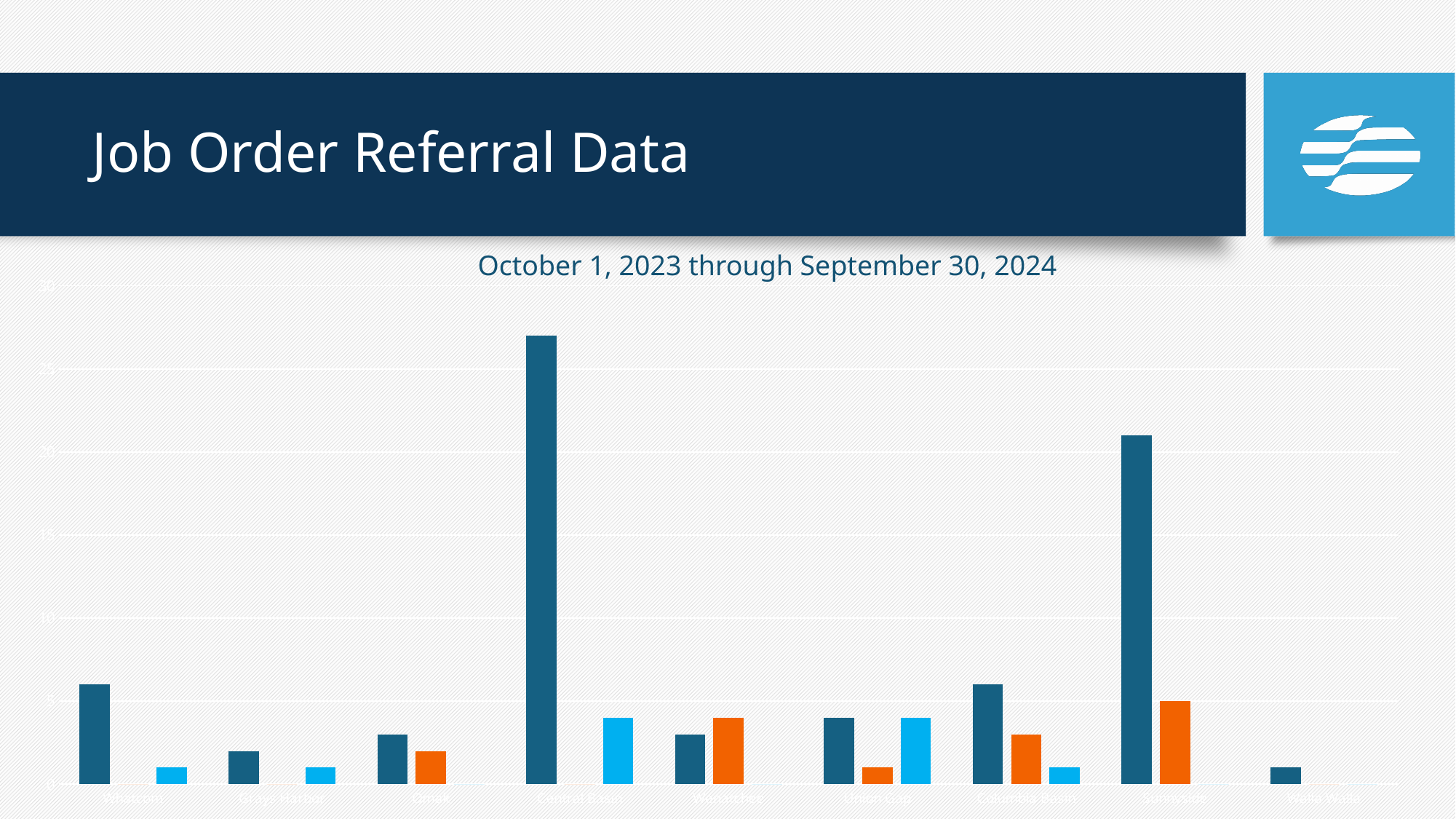
Which category has the tallest bar in the chart? Central Basin Is the orange bar for Sunnyside greater or less than 10? less Which is larger, the dark blue bar for Central Basin or the dark blue bar for Sunnyside? Central Basin Is the dark blue bar for Whatcom greater or less than 5? greater Is the dark blue bar for Sunnyside greater or less than 20? greater How many category groups are shown along the x axis of the chart? 9 What is the title of the slide containing the chart? Job Order Referral Data What date range does the chart's subtitle give? October 1, 2023 through September 30, 2024 Which is larger, the dark blue bar for Columbia Basin or the dark blue bar for Grays Harbor? Columbia Basin What kind of chart is shown on the slide? bar chart